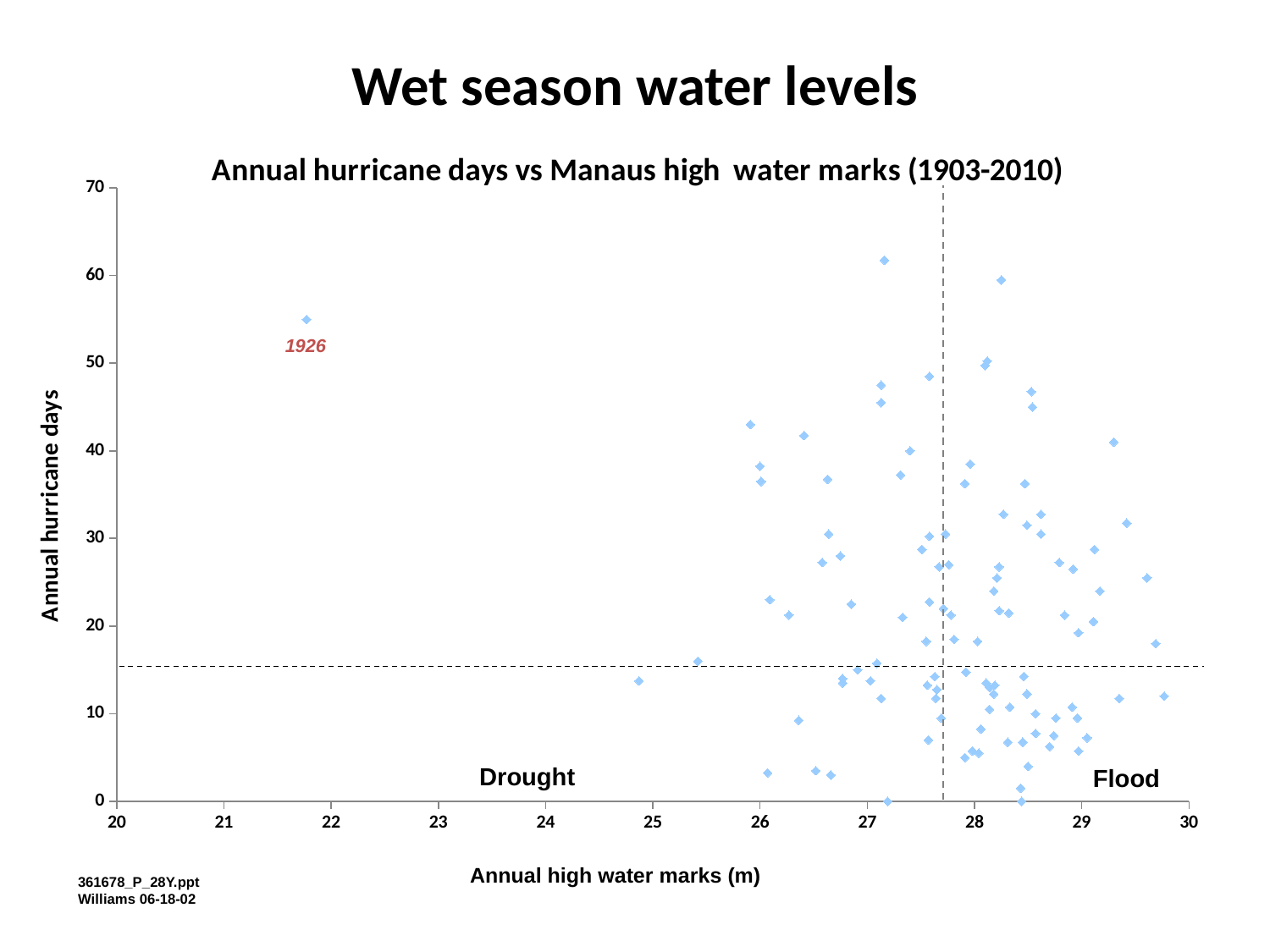
Is the annual hurricane days value for the point labelled 1926 greater or less than 60? less Do most of the points have an annual high water mark greater or less than 25? greater What is the title of the chart? Annual hurricane days vs Manaus high water marks (1903-2010) Is the annual hurricane days value for the point labelled 1926 greater or less than 50? greater What kind of chart is shown on the slide? scatter chart Which year is labelled next to the isolated point on the left of the chart? 1926